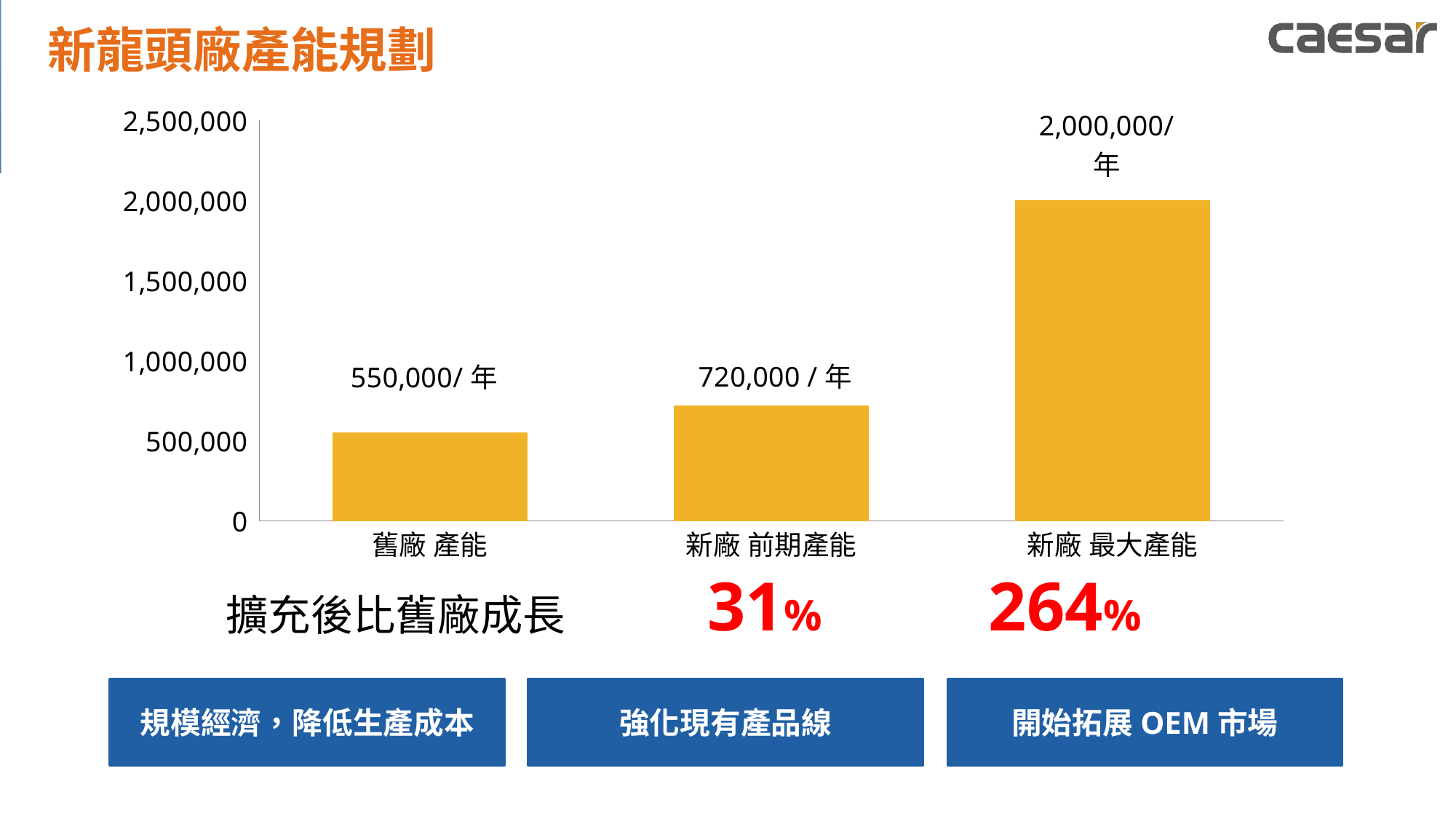
How many categories are shown in the chart? 3 Which category has the lowest value? 舊廠 產能 What is the value shown for 新廠 前期產能? 720,000 / 年 What is the value shown for 新廠 最大產能? 2,000,000/ 年 Which is larger, 新廠 前期產能 or 舊廠 產能? 新廠 前期產能 Which category has the highest value? 新廠 最大產能 Is the value for 新廠 前期產能 greater or less than 1,000,000? less What is the difference between 新廠 最大產能 and 舊廠 產能? 1,450,000 What is the value shown for 舊廠 產能? 550,000/ 年 What is the highest value labelled on the vertical axis? 2,500,000 What is the difference between 新廠 前期產能 and 舊廠 產能? 170,000 What kind of chart is shown on the slide? bar chart